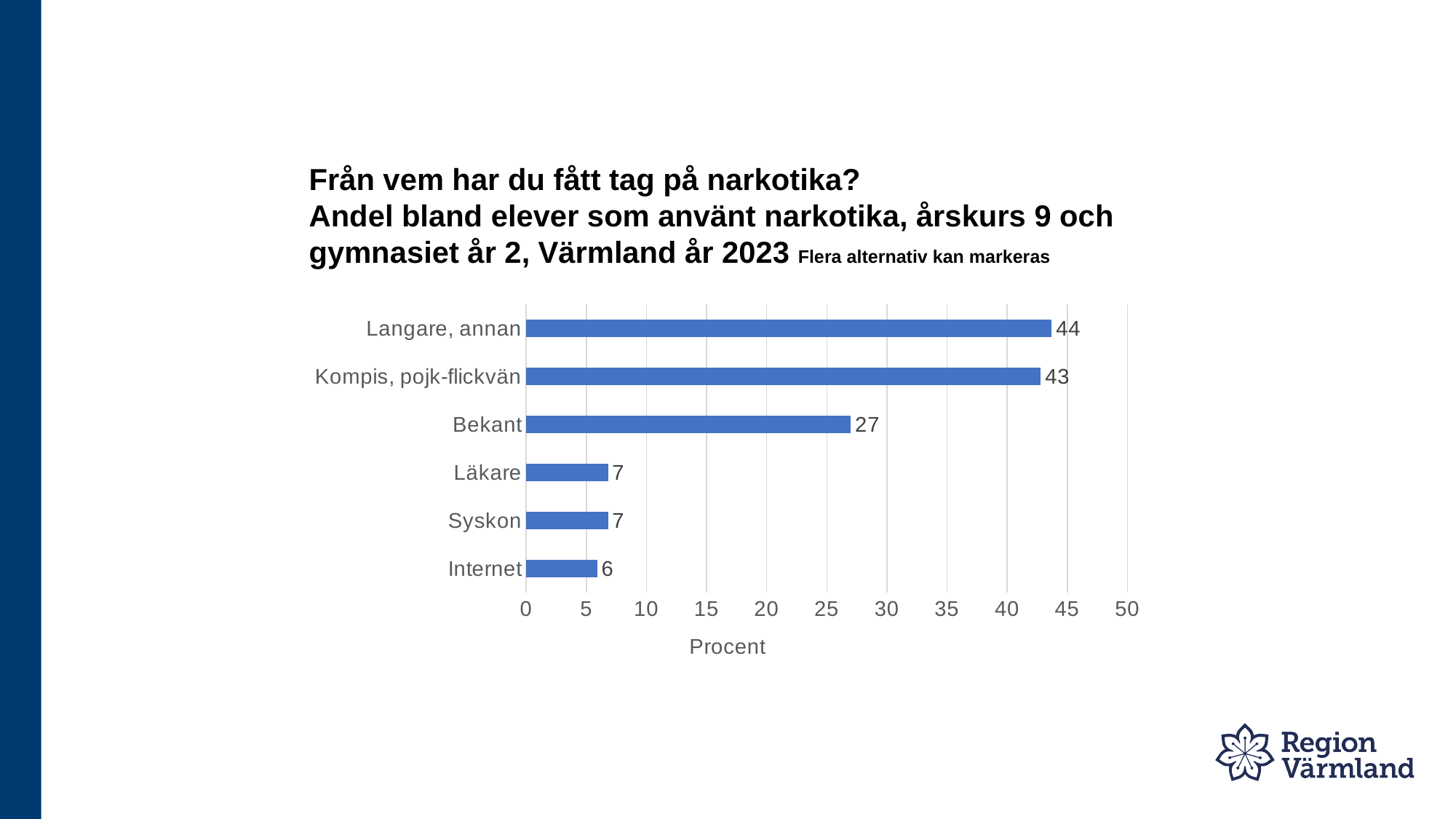
Which category has the lowest value? Internet What is the value for Internet? 6 Is the value for Bekant greater or less than 25? greater What is the value for Bekant? 27 How many categories are shown in the chart? 6 What is the difference between the values for Kompis, pojk-flickvän and Internet? 37 Which category has the highest value? Langare, annan What kind of chart is shown on the slide? Bar chart What is the label of the horizontal axis? Procent What is the difference between the values for Langare, annan and Bekant? 17 Which is larger, the value for Bekant or the value for Läkare? Bekant What is the value for Kompis, pojk-flickvän? 43